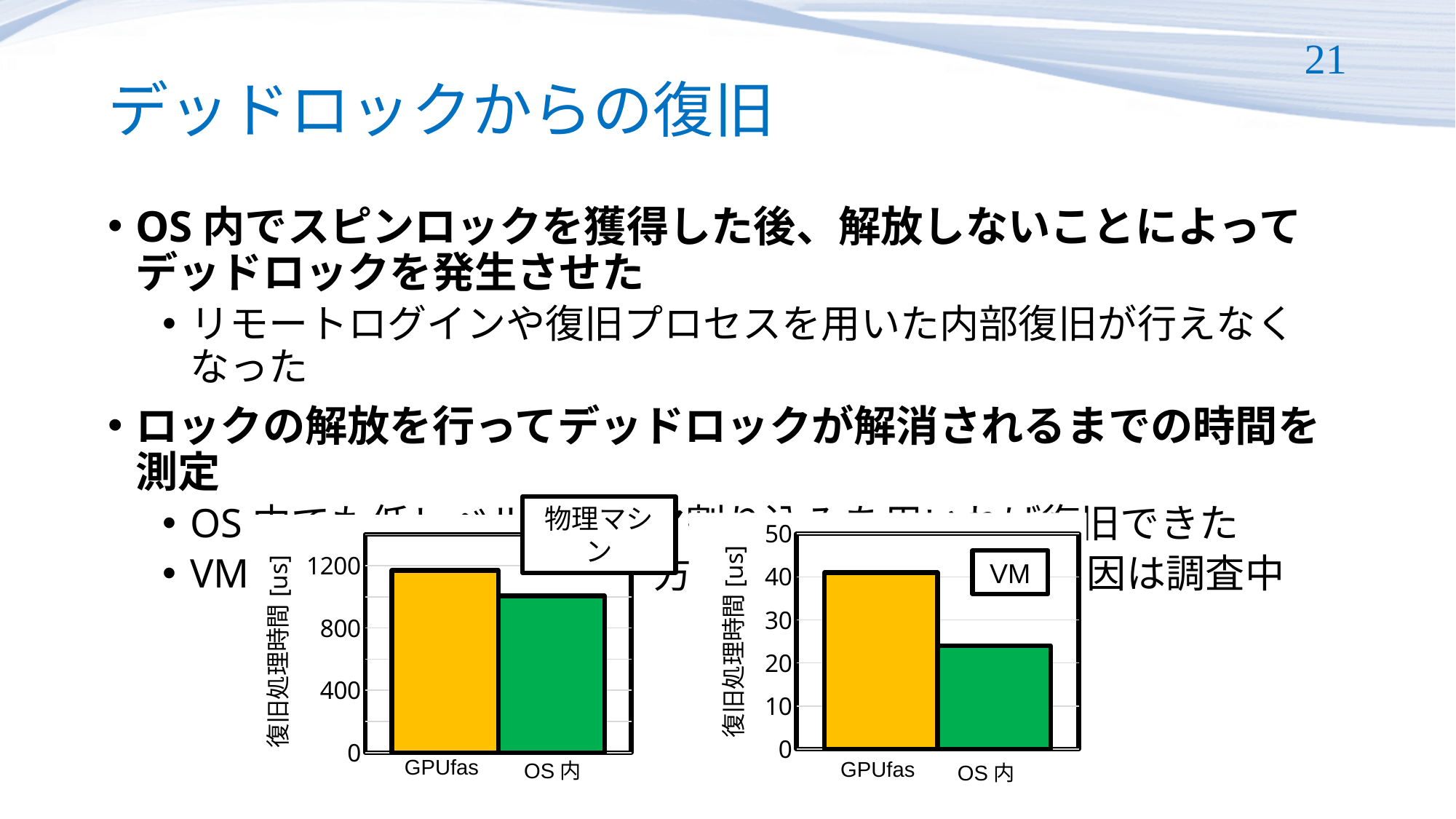
In the right chart (VM), is the value for GPUfas greater or less than 30? greater In the right chart (VM), is the bar for GPUfas larger or smaller than the bar for OS内? larger In the right chart (VM), is the value for OS内 greater or less than 20? greater In the right chart (VM), which category has the lower recovery time? OS内 In the left chart (物理マシン), which category has the higher recovery time, GPUfas or OS内? GPUfas What is the y-axis label of the left chart (物理マシン)? 復旧処理時間 [us] In the left chart (物理マシン), is the value for OS内 greater or less than 800? greater What kind of chart is the left chart labelled 物理マシン? bar chart How many categories are plotted in the right chart (VM)? 2 What is the highest tick value shown on the y axis of the right chart (VM)? 50